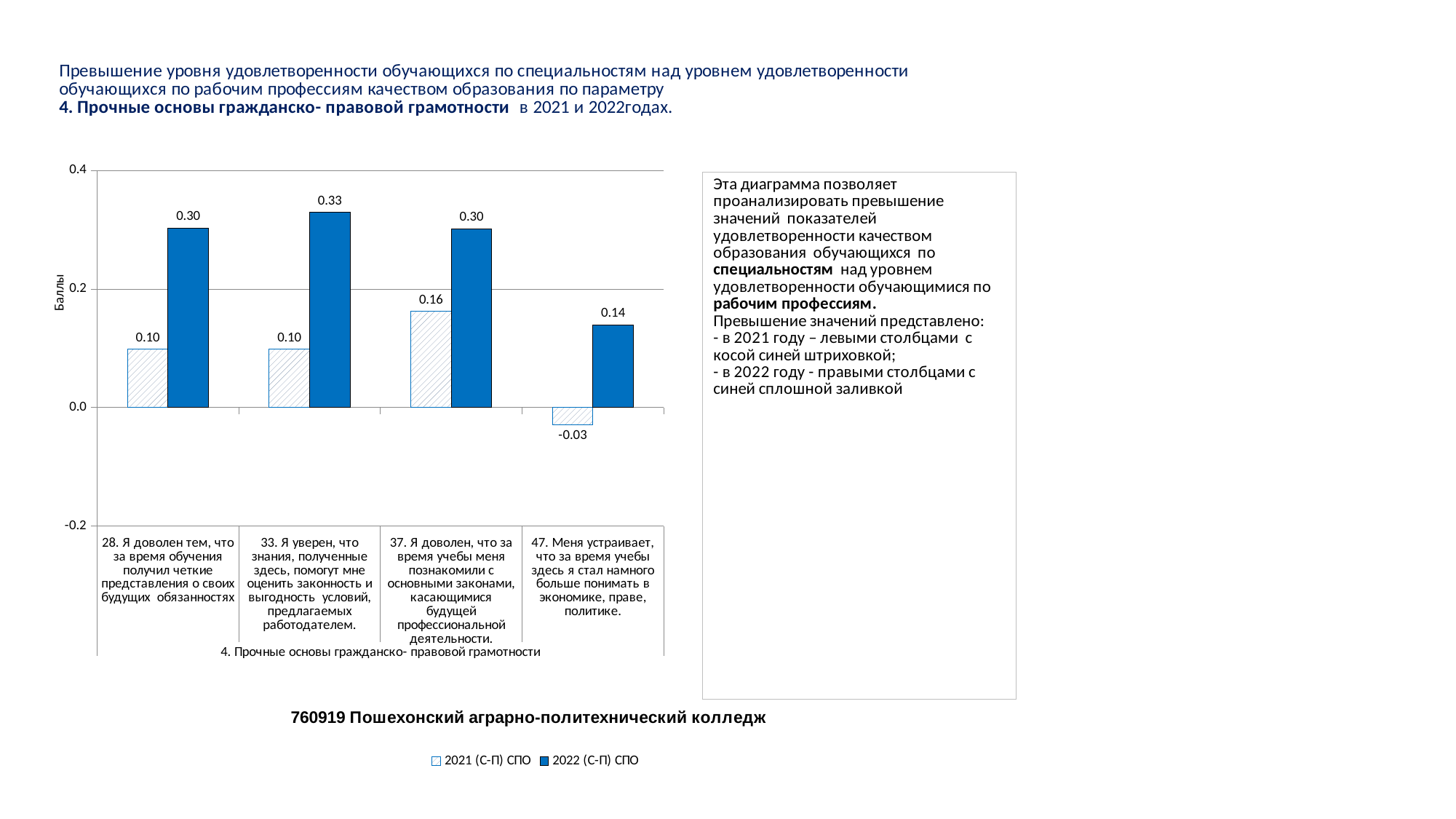
What is the label of the y axis? Баллы What is the value of the 2021 (С-П) СПО series for question 47? -0.03 Is the 2022 (С-П) СПО value for question 28 greater or less than 0.2? greater Which question has the highest value in the 2022 (С-П) СПО series? 33 What type of chart is shown on the slide? bar chart What is the value of the 2022 (С-П) СПО series for question 33? 0.33 Which question has the lowest value in the 2021 (С-П) СПО series? 47 What is the difference between the 2022 and 2021 values for question 37? 0.14 How many series does the legend list? 2 For question 47, which series has the larger value, 2021 (С-П) СПО or 2022 (С-П) СПО? 2022 (С-П) СПО What is the value of the 2021 (С-П) СПО series for question 37? 0.16 How many categories (questions) are shown on the x axis? 4